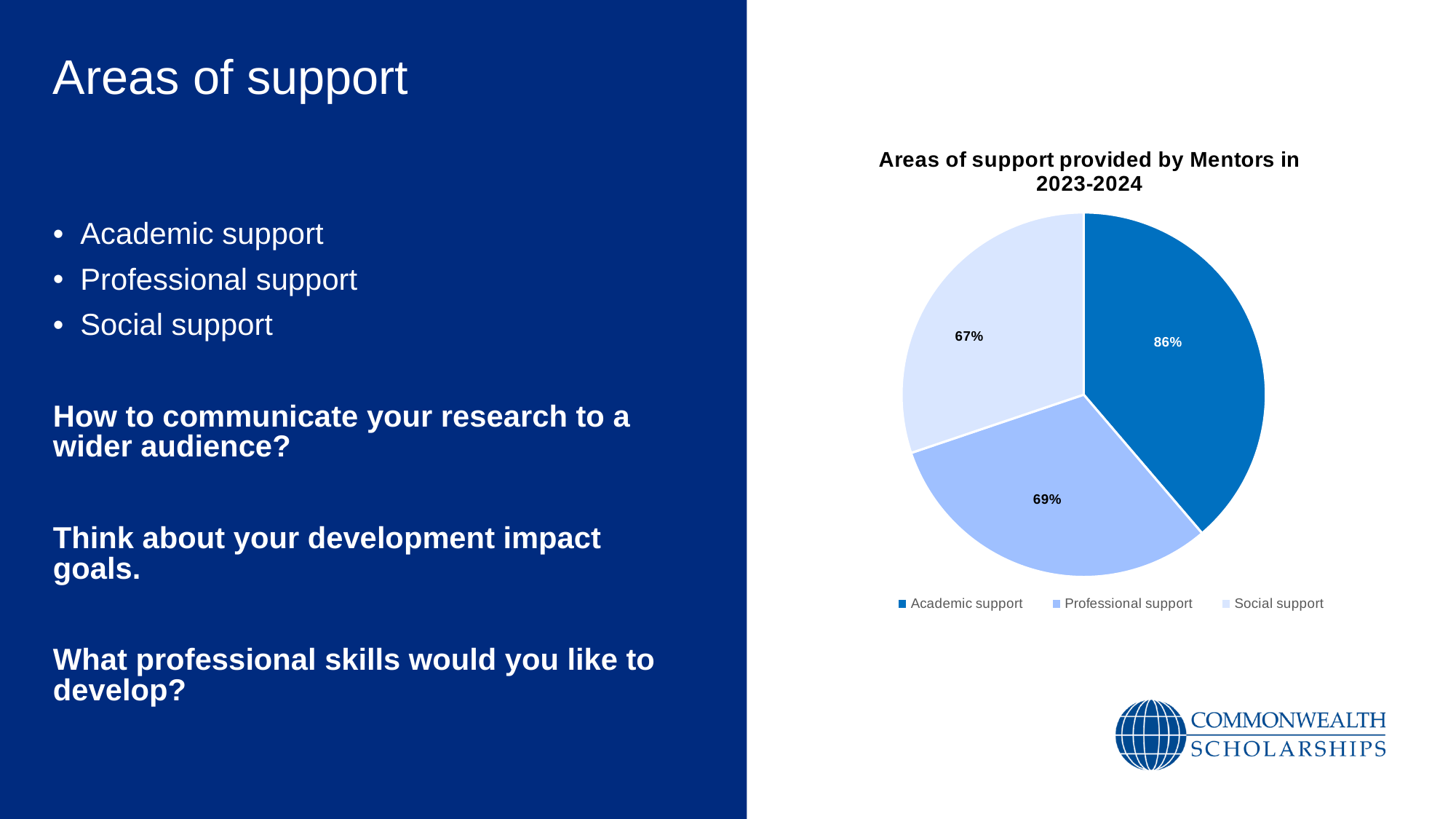
How many entries does the chart legend list? 3 What value is shown for Academic support? 86% What type of chart is shown on the slide? pie chart What value is shown for Professional support? 69% Which slice of the pie is shown in the darkest blue? Academic support Which area of support has the highest value? Academic support What value is shown for Social support? 67% What is the difference between the values for Academic support and Professional support? 17 percentage points Which is larger, the value for Academic support or the value for Social support? Academic support Which area of support has the lowest value? Social support How many slices does the pie chart have? 3 What is the title of the chart? Areas of support provided by Mentors in 2023-2024